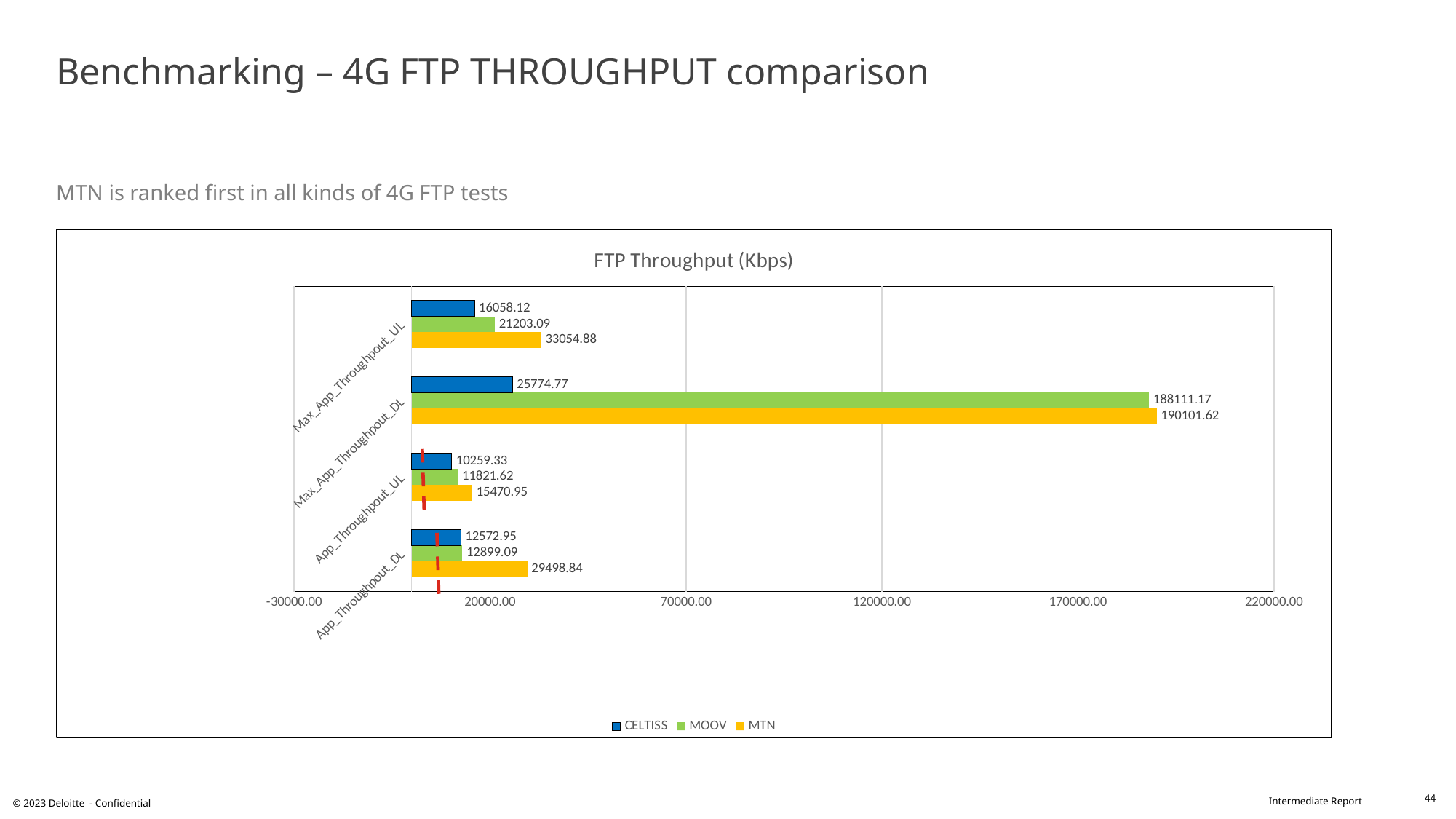
What is the CELTISS value for App_Throughpout_UL? 10259.33 Which is larger for App_Throughpout_UL: the MOOV value or the MTN value? MTN What is the MOOV value for Max_App_Throughpout_UL? 21203.09 What kind of chart is shown on the slide? Bar chart What is the difference between the MTN and CELTISS values for Max_App_Throughpout_UL? 16996.76 How many series does the legend list? 3 What is the title of the chart? FTP Throughput (Kbps) How many categories are shown on the chart? 4 Which operator has the lowest value for Max_App_Throughpout_DL? CELTISS What is the difference between the MTN and MOOV values for Max_App_Throughpout_DL? 1990.45 What is the MTN value for Max_App_Throughpout_DL? 190101.62 Which operator has the highest value for App_Throughpout_DL? MTN